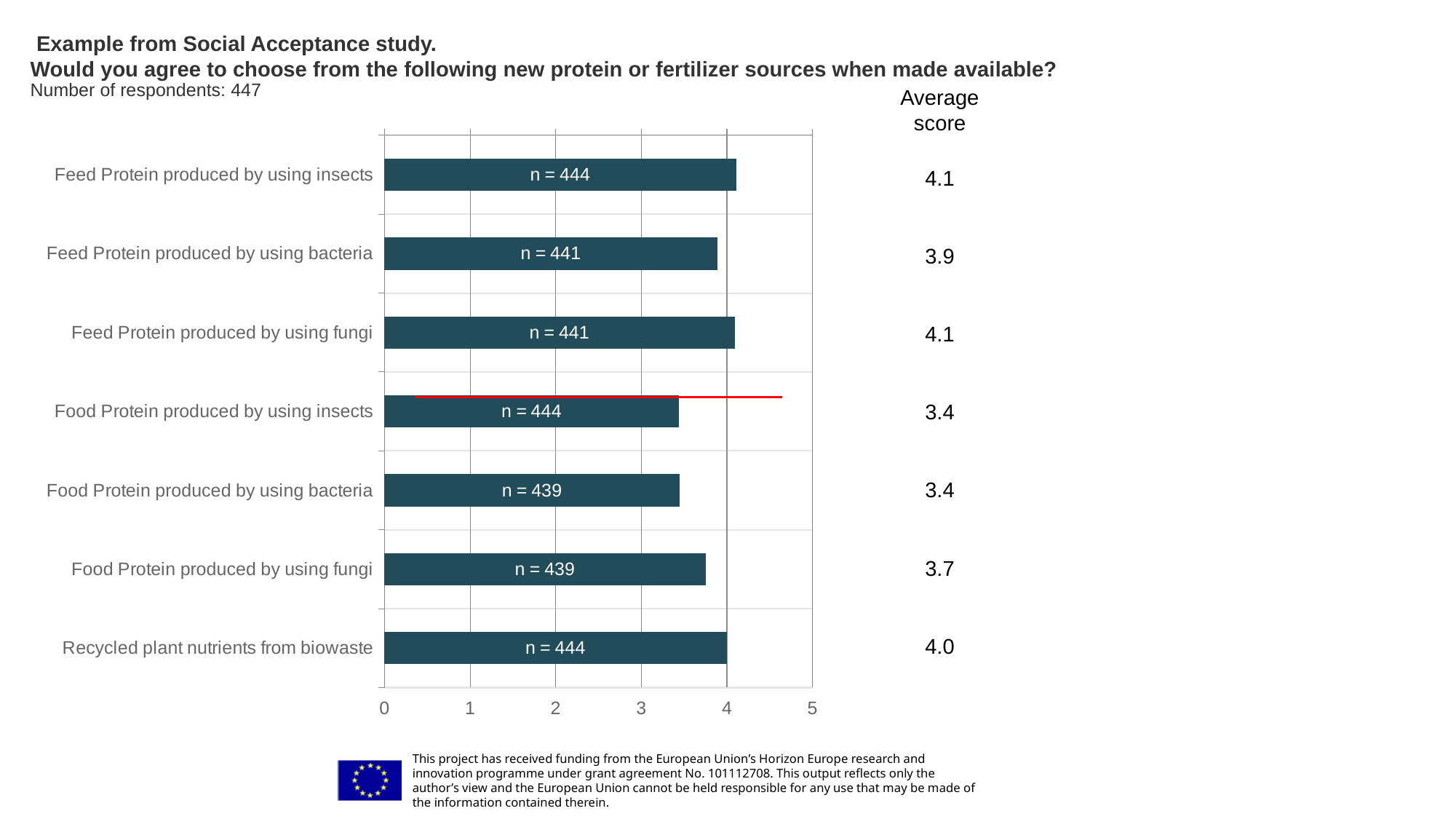
What is the n value printed on the bar for Food Protein produced by using bacteria? n = 439 What is the average score for Recycled plant nutrients from biowaste? 4.0 What is the average score for Feed Protein produced by using bacteria? 3.9 Which has the higher average score: Feed Protein produced by using insects or Food Protein produced by using insects? Feed Protein produced by using insects Is the average score for Food Protein produced by using fungi greater or less than 3? greater What is the average score for Food Protein produced by using fungi? 3.7 What is the difference between the average scores for Feed Protein produced by using fungi and Food Protein produced by using bacteria? 0.7 What kind of chart is shown on the slide? Bar chart How many protein or fertilizer sources are shown as bars in the chart? 7 Which has the lower average score: Food Protein produced by using bacteria or Recycled plant nutrients from biowaste? Food Protein produced by using bacteria What is the number of respondents stated on the slide? 447 What is the average score for Food Protein produced by using insects? 3.4